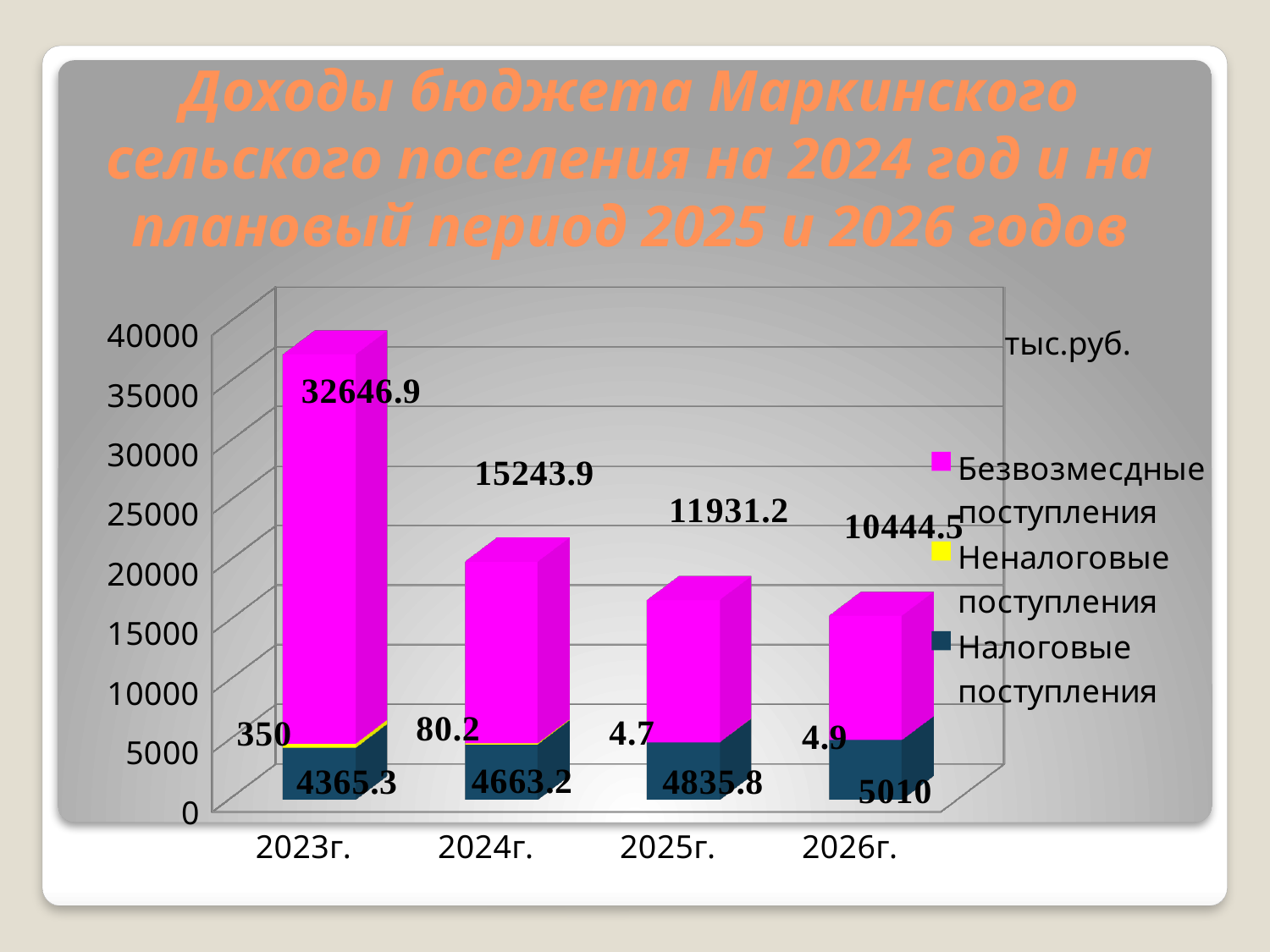
What is the value of Безвозмездные поступления for 2023г.? 32646.9 How many years are shown on the x axis? 4 What kind of chart is shown on the slide? Stacked bar chart What is the difference between Безвозмездные поступления in 2023г. and 2024г.? 17403 What is the total of the stacked bar for 2026г.? 15459.4 Which is larger: Налоговые поступления in 2024г. or in 2026г.? 2026г. What is the value of Налоговые поступления for 2025г.? 4835.8 In which year is Безвозмездные поступления highest? 2023г. How many series does the legend list? 3 What is the value of Неналоговые поступления for 2024г.? 80.2 In which year is Неналоговые поступления lowest? 2025г. What is the value of Налоговые поступления for 2026г.? 5010